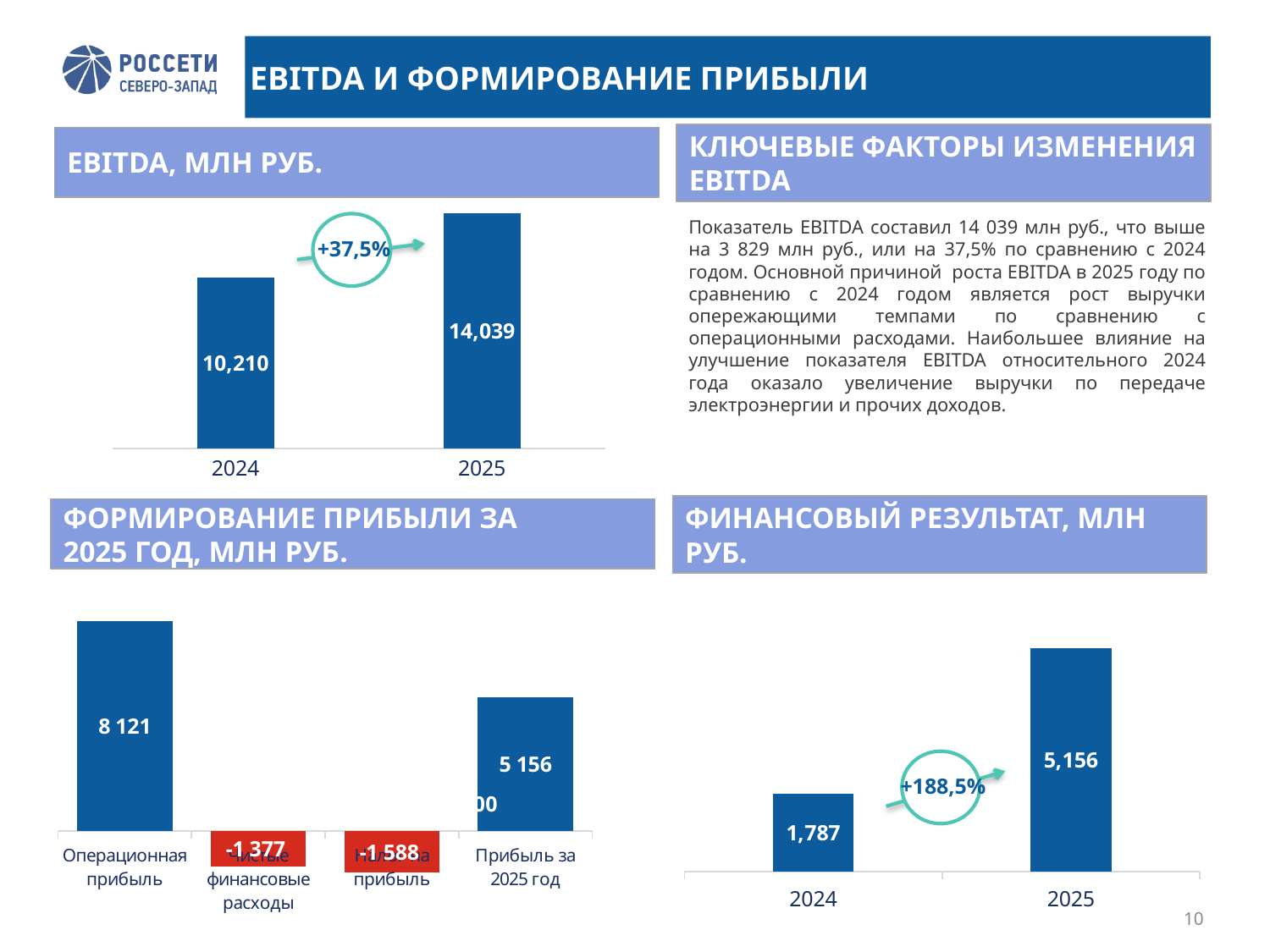
In the 'EBITDA, МЛН РУБ.' chart, do the values rise or fall from 2024 to 2025? rise In the 'EBITDA, МЛН РУБ.' chart, what is the value for 2024? 10,210 What type of chart is the 'ФОРМИРОВАНИЕ ПРИБЫЛИ ЗА 2025 ГОД, МЛН РУБ.' chart? bar chart In the 'EBITDA, МЛН РУБ.' chart, what is the difference between the 2025 and 2024 values? 3,829 In the 'ФИНАНСОВЫЙ РЕЗУЛЬТАТ, МЛН РУБ.' chart, what percentage change is shown between 2024 and 2025? +188,5% In the 'ФОРМИРОВАНИЕ ПРИБЫЛИ ЗА 2025 ГОД, МЛН РУБ.' chart, what is the value for Операционная прибыль? 8 121 In the 'ФОРМИРОВАНИЕ ПРИБЫЛИ ЗА 2025 ГОД, МЛН РУБ.' chart, what is the value for Прибыль за 2025 год? 5 156 In the 'ФИНАНСОВЫЙ РЕЗУЛЬТАТ, МЛН РУБ.' chart, which year has the higher value? 2025 In the 'ФИНАНСОВЫЙ РЕЗУЛЬТАТ, МЛН РУБ.' chart, what is the value for 2025? 5,156 In the 'EBITDA, МЛН РУБ.' chart, what is the value for 2025? 14,039 In the 'EBITDA, МЛН РУБ.' chart, what percentage change is shown between 2024 and 2025? +37,5% In the 'ФИНАНСОВЫЙ РЕЗУЛЬТАТ, МЛН РУБ.' chart, what is the value for 2024? 1,787